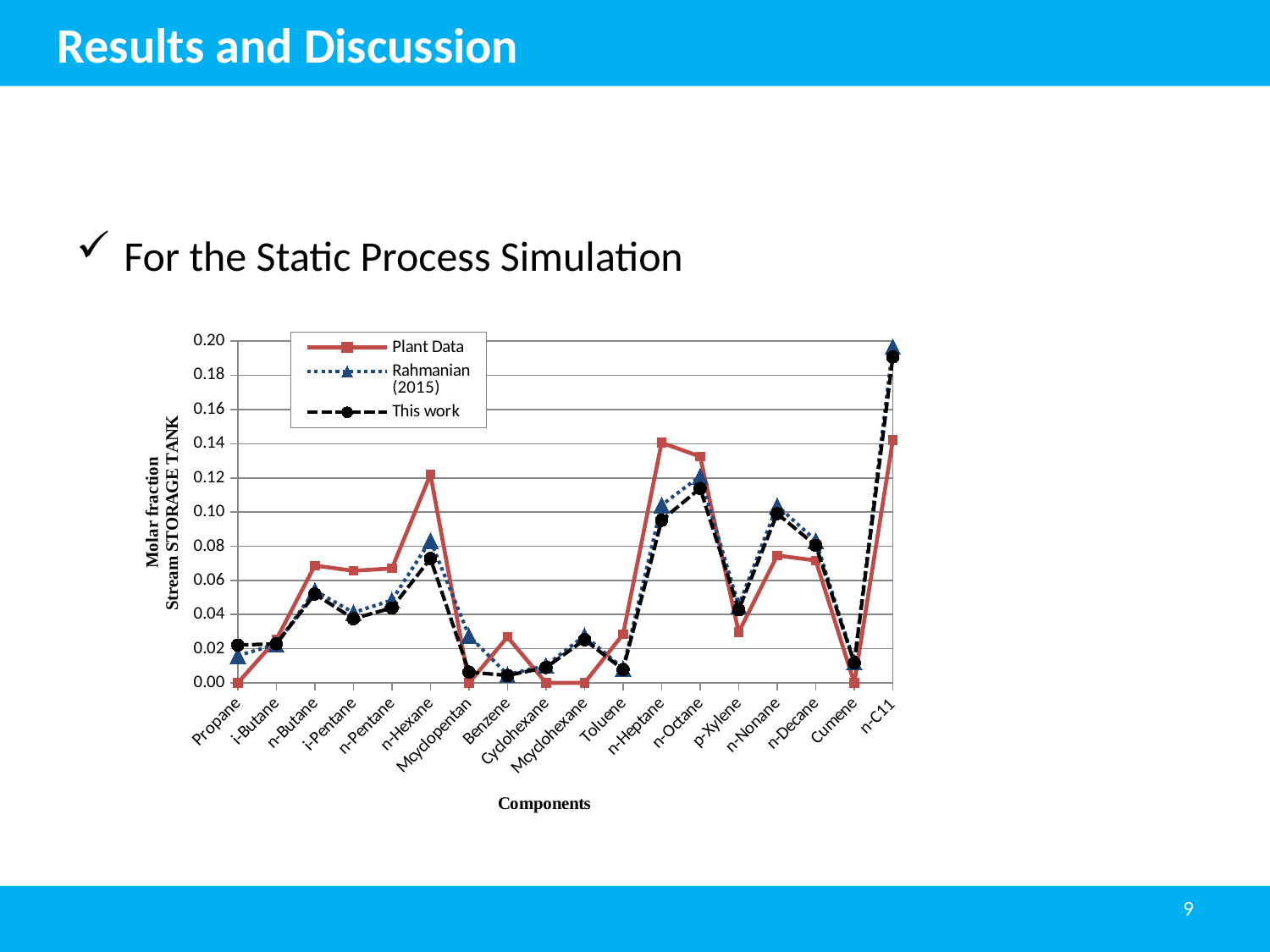
Is the This work value for n-Octane greater or less than 0.10? greater Is the Plant Data value for n-Heptane greater or less than 0.12? greater Which component has the highest value for the This work series? n-C11 How many components are plotted along the x axis of the chart? 18 Which component has the highest value for the Rahmanian (2015) series? n-C11 Is the Plant Data value for p-Xylene greater or less than 0.04? less At n-Hexane, which series has the larger value: Plant Data or This work? Plant Data What is the title of the x axis of the chart? Components What kind of chart is shown on the slide? line chart How many series does the chart legend list? 3 At n-C11, which series has the larger value: Plant Data or This work? This work